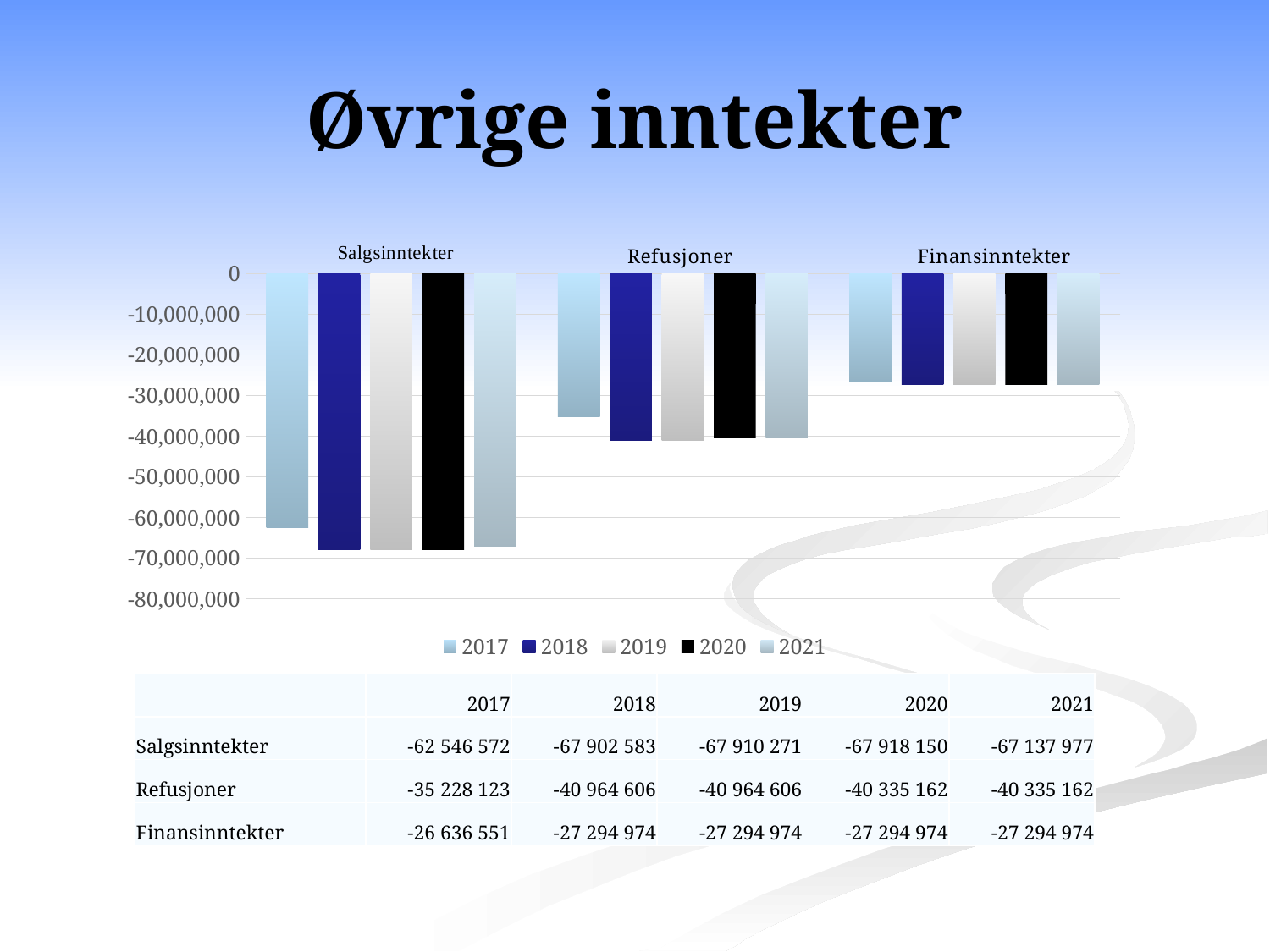
What is the value for Refusjoner in 2018? -40 964 606 Is the value for Refusjoner in 2017 greater or less than -30,000,000? less What is the difference between the Refusjoner values for 2018 and 2017? 5 736 483 What kind of chart is shown on the slide? bar chart How many series does the legend list? 5 How many categories are shown on the x axis of the chart? 3 What is the value for Salgsinntekter in 2020? -67 918 150 What is the value for Salgsinntekter in 2017? -62 546 572 Which category has the bar extending furthest below zero in 2017? Salgsinntekter What is the value for Finansinntekter in 2021? -27 294 974 Which category has the bars closest to zero across all years? Finansinntekter Which bar extends further below zero for Salgsinntekter: 2017 or 2018? 2018